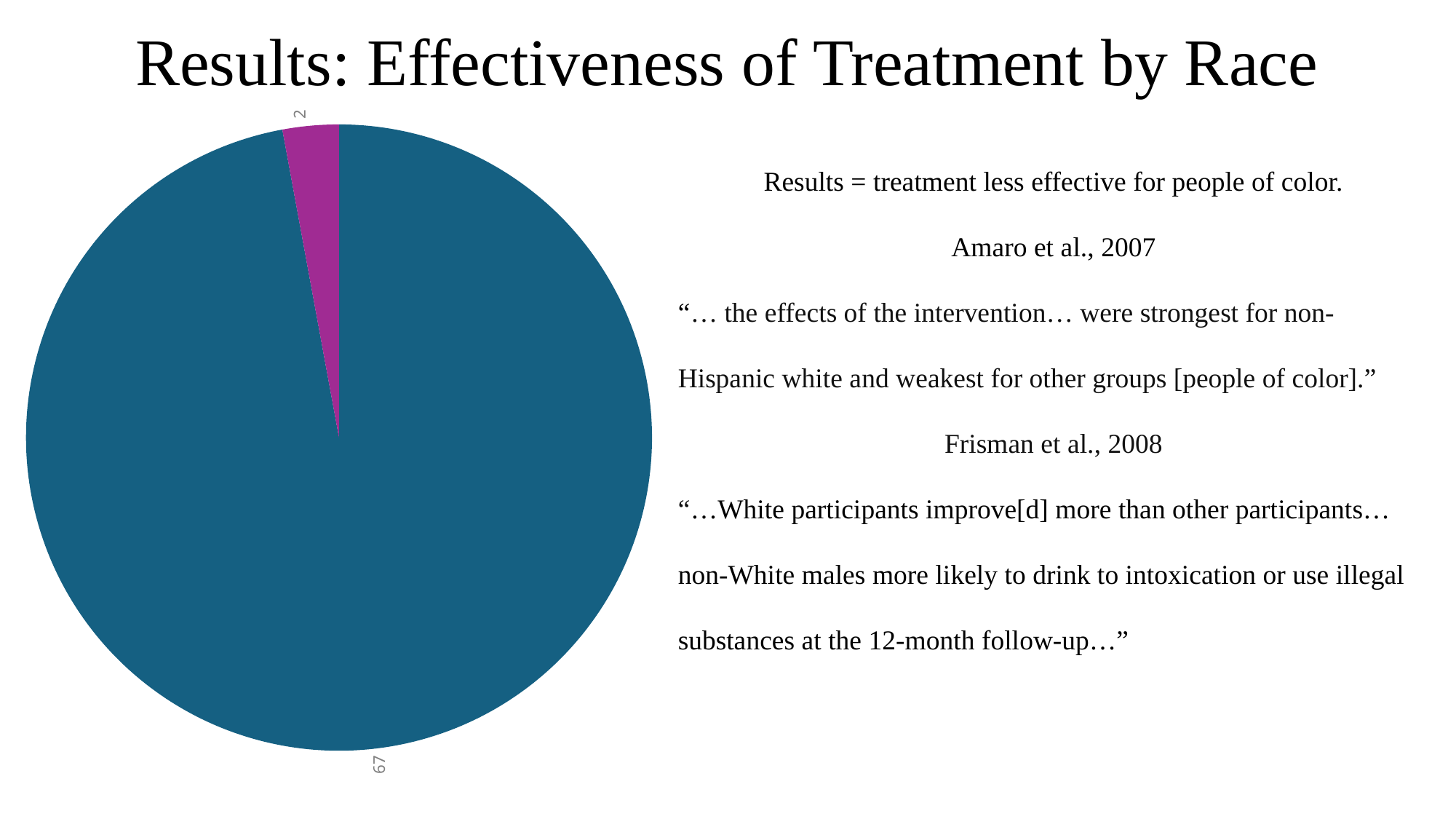
What is the value of the smallest slice in the pie chart? 2 What is the value of the largest slice in the pie chart? 67 What value is labelled on the small purple slice of the pie chart? 2 What value is labelled on the large blue slice of the pie chart? 67 What is the difference between the two slice values in the pie chart? 65 What colour is the slice labelled 67 in the pie chart? blue What colour is the slice labelled 2 in the pie chart? purple What is the total of the two slice values in the pie chart? 69 Which slice is larger, the blue slice or the purple slice? the blue slice How many slices does the pie chart have? 2 What kind of chart is shown on the slide? pie chart